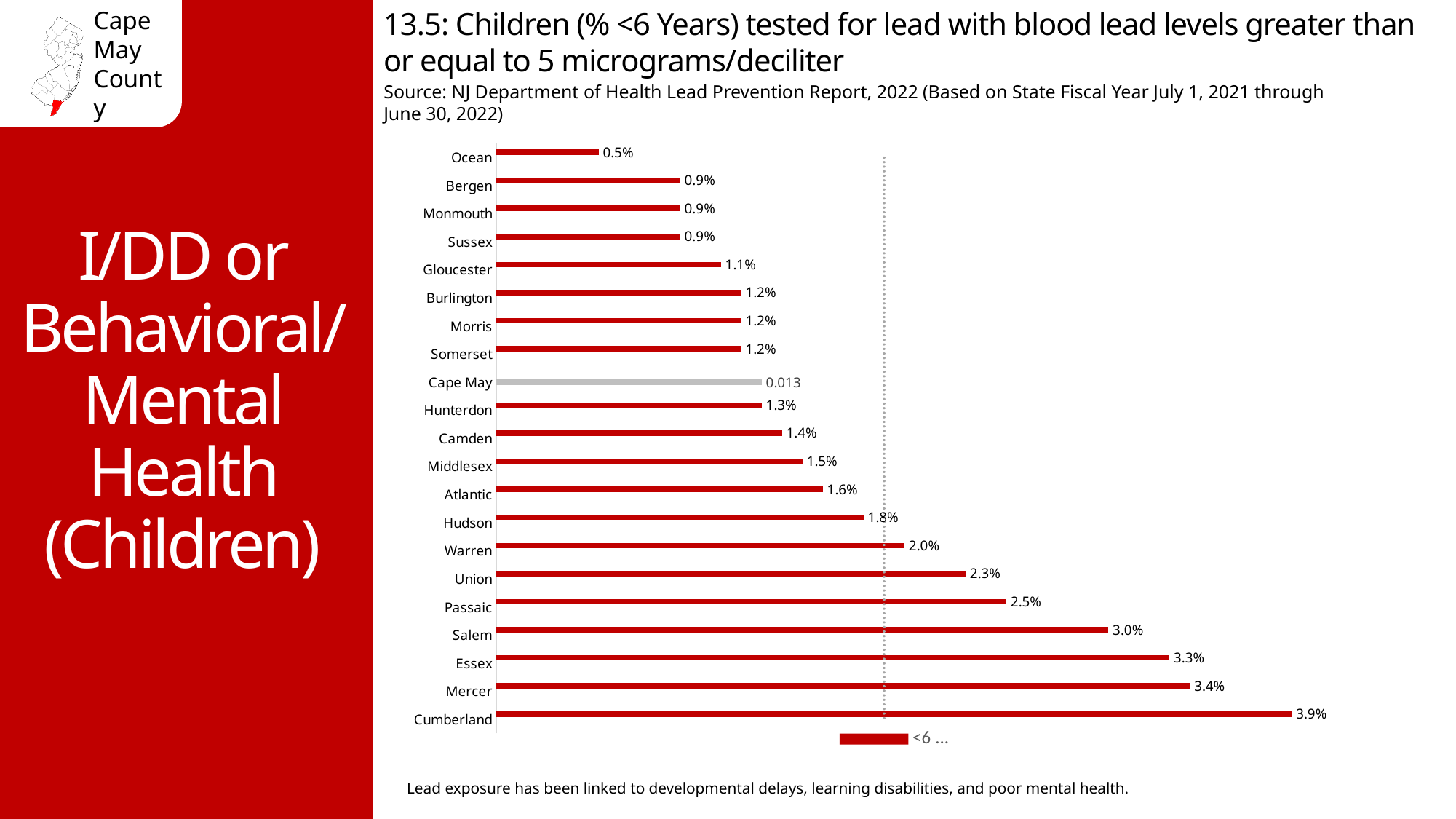
Which county has the lowest value? Ocean How many counties are shown in the chart? 21 What is the value for Cumberland? 3.9% What kind of chart is shown on the slide? Bar chart What value is shown for Cape May? 0.013 What colour is the bar for Cape May? Gray What is the value for Ocean? 0.5% What is the difference between the values for Mercer and Essex? 0.1 percentage points What is the difference between the values for Cumberland and Ocean? 3.4 percentage points What is the value for Salem? 3.0% Which is larger, the value for Passaic or the value for Union? Passaic Which county has the highest value? Cumberland